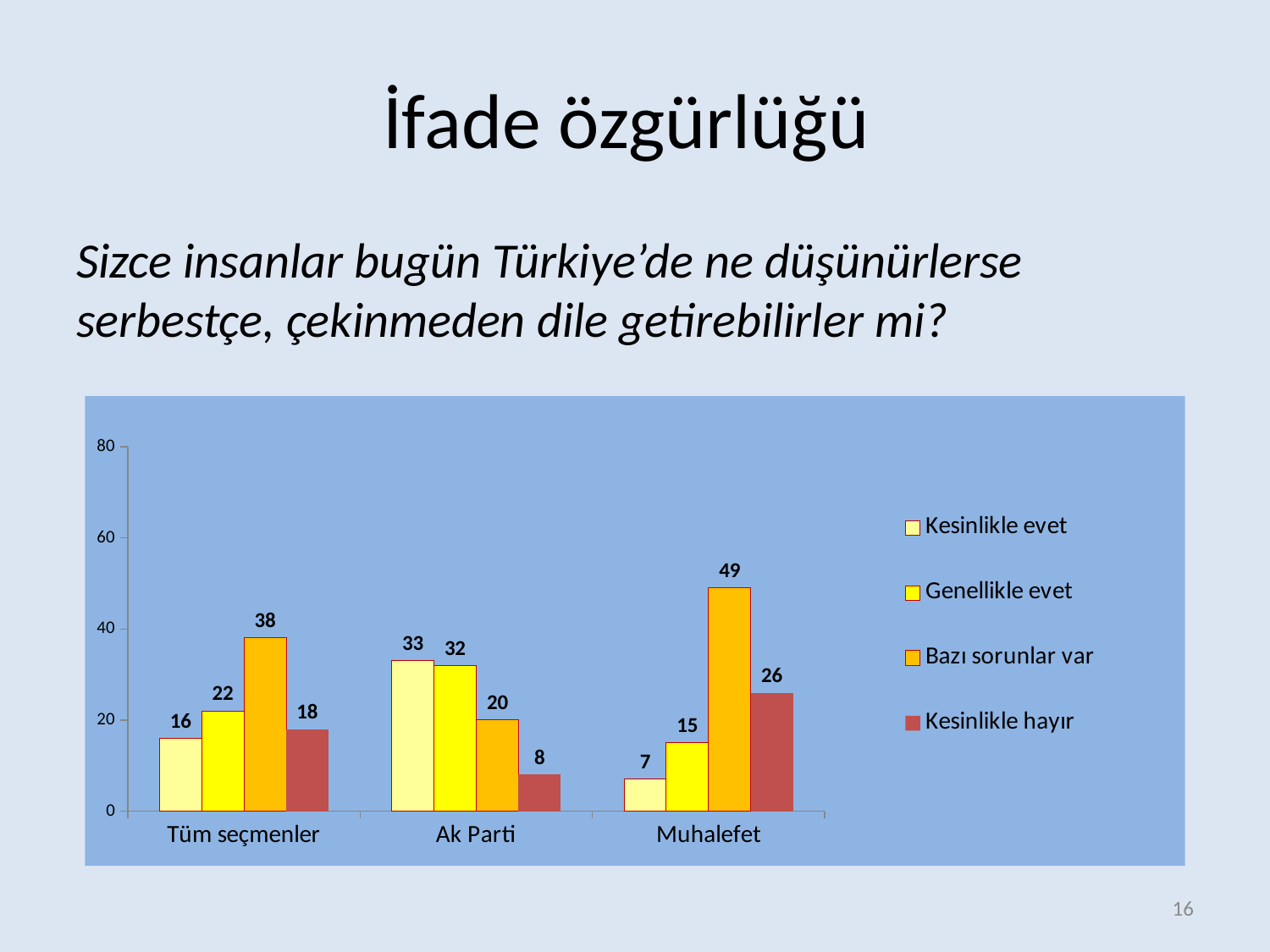
Is the value for "Bazı sorunlar var" in the Muhalefet category greater or less than 40? greater How many categories are shown on the x axis? 3 What is the value for "Bazı sorunlar var" in the Muhalefet category? 49 Which is larger: "Genellikle evet" for Tüm seçmenler or "Genellikle evet" for Ak Parti? Ak Parti Which category has the lowest value for "Kesinlikle evet"? Muhalefet Which category has the highest value for "Kesinlikle hayır"? Muhalefet What is the value for "Kesinlikle hayır" in the Tüm seçmenler category? 18 Which legend entry is shown in red? Kesinlikle hayır What is the difference between the "Bazı sorunlar var" values for Muhalefet and Ak Parti? 29 How many series does the legend list? 4 What kind of chart is shown on the slide? Bar chart What is the value for "Kesinlikle evet" in the Ak Parti category? 33